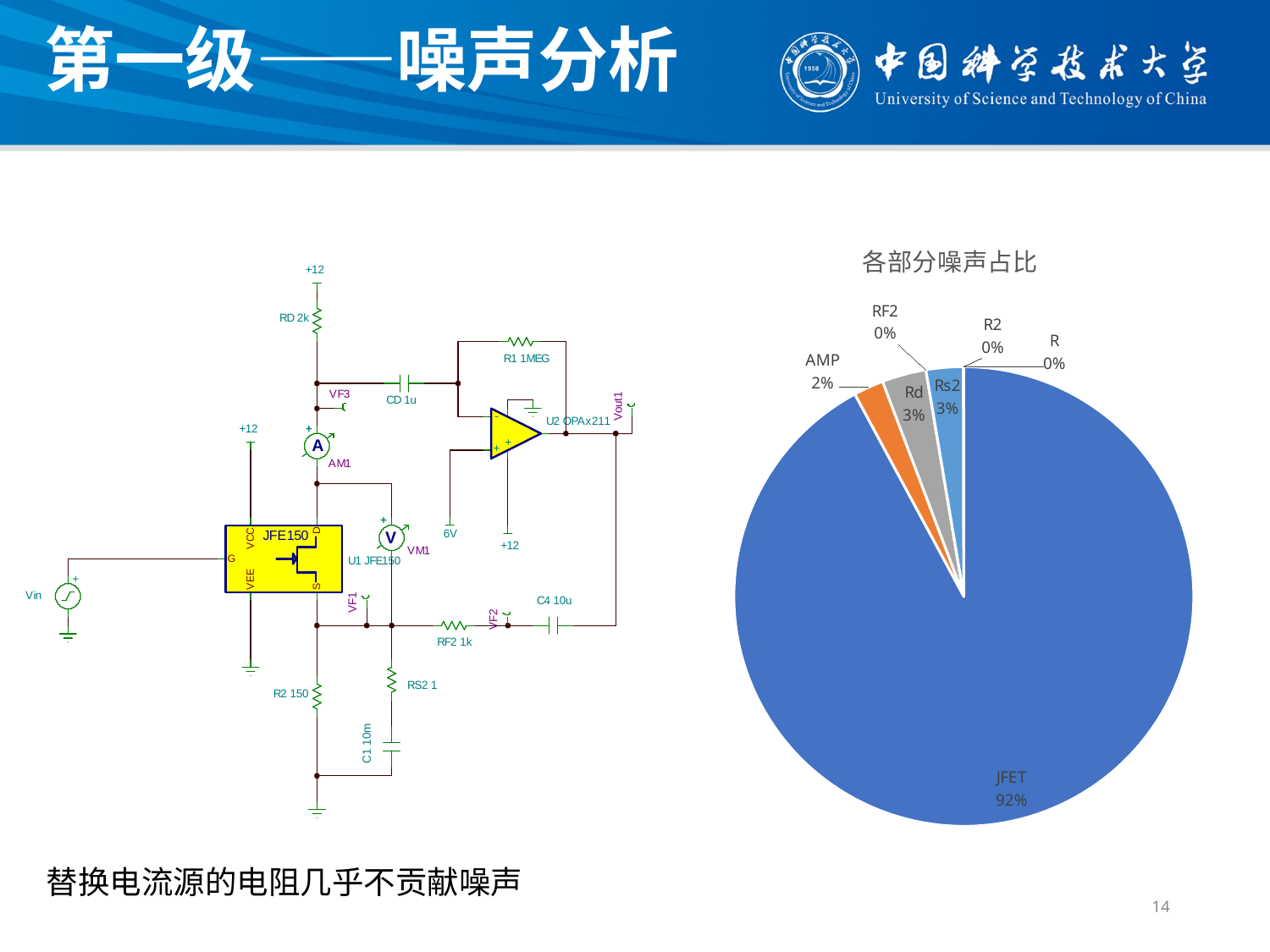
How many categories are shown in the pie chart? 7 What share of the pie does Rd account for? 3% What share of the pie does AMP account for? 2% What share of the pie does JFET account for? 92% What is the title of the pie chart? 各部分噪声占比 What is the combined share of Rs2 and Rd? 6% What kind of chart is shown on the slide? pie chart Which is larger, the share for AMP or the share for Rd? Rd Which category has the largest slice of the pie? JFET What is the difference between the JFET share and the AMP share? 90%